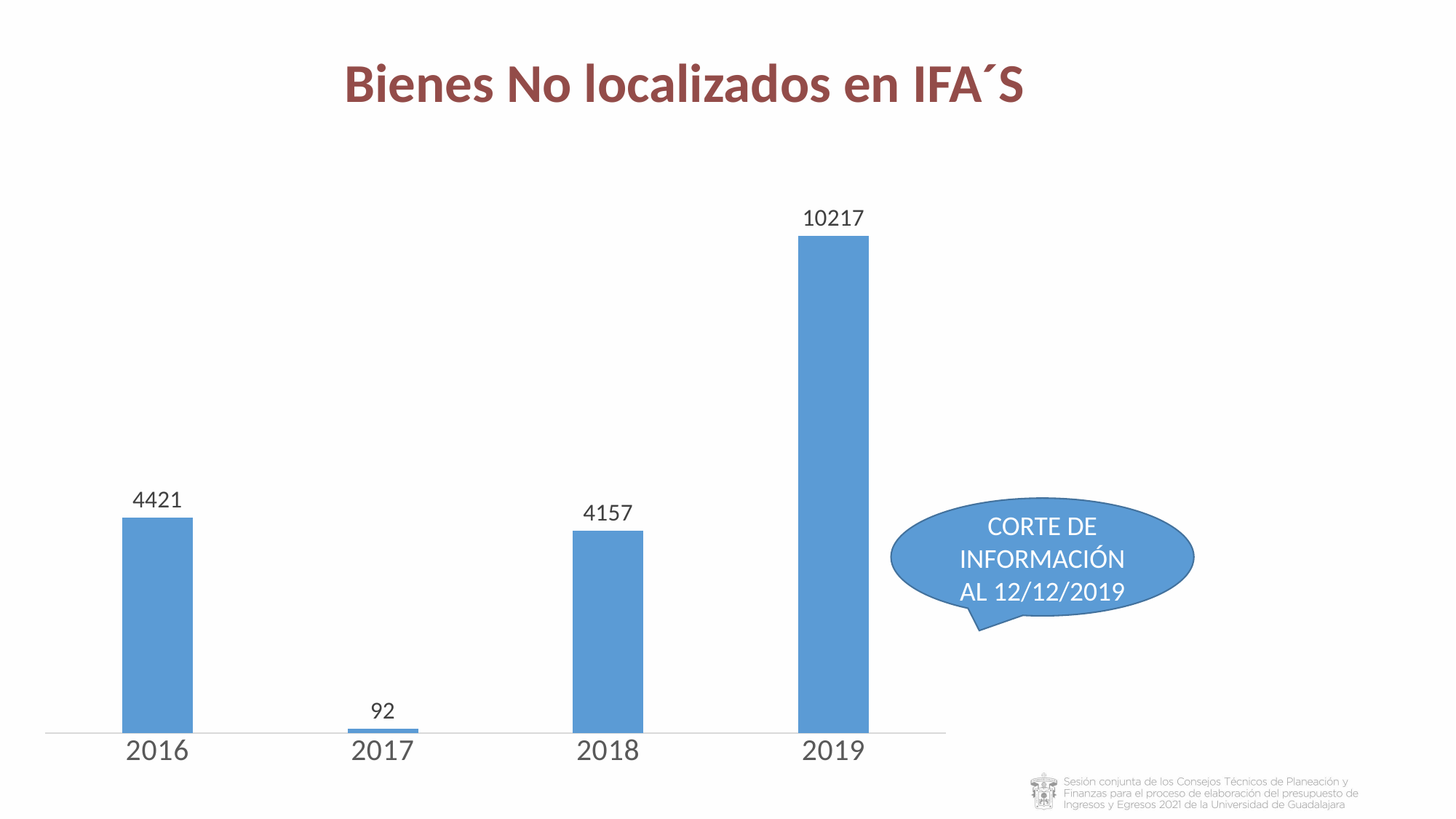
What kind of chart is shown on the slide? Bar chart What is the value for 2018? 4157 What is the title of the chart? Bienes No localizados en IFA´S What is the value for 2017? 92 What is the difference between the values for 2016 and 2018? 264 Which year has the highest value? 2019 Which year has the lowest value? 2017 How many years are shown on the x axis? 4 What is the difference between the values for 2019 and 2018? 6060 Which is larger, the value for 2016 or the value for 2018? 2016 What is the value for 2016? 4421 What is the value for 2019? 10217